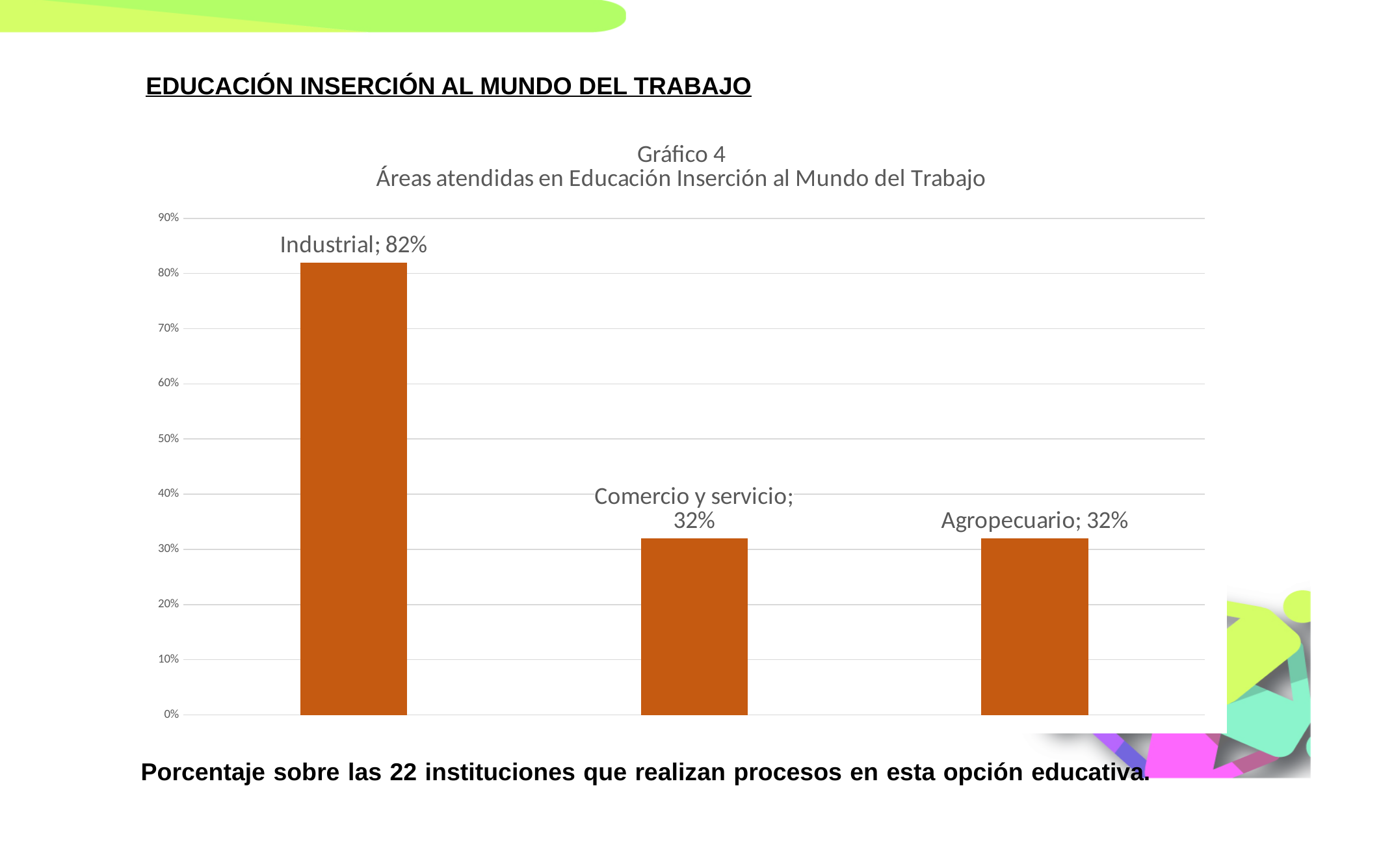
What is the value for Industrial? 82% Is the value for Agropecuario greater or less than 40%? less How many categories are shown in the chart? 3 What is the highest value shown on the vertical axis? 90% Is the value for Industrial greater or less than 70%? greater Which category has the highest value? Industrial What is the title of the chart? Gráfico 4 Áreas atendidas en Educación Inserción al Mundo del Trabajo Which is larger, the value for Industrial or the value for Comercio y servicio? Industrial What is the value for Comercio y servicio? 32% What is the difference between the values for Industrial and Agropecuario? 50% What is the value for Agropecuario? 32% What kind of chart is shown on the slide? bar chart